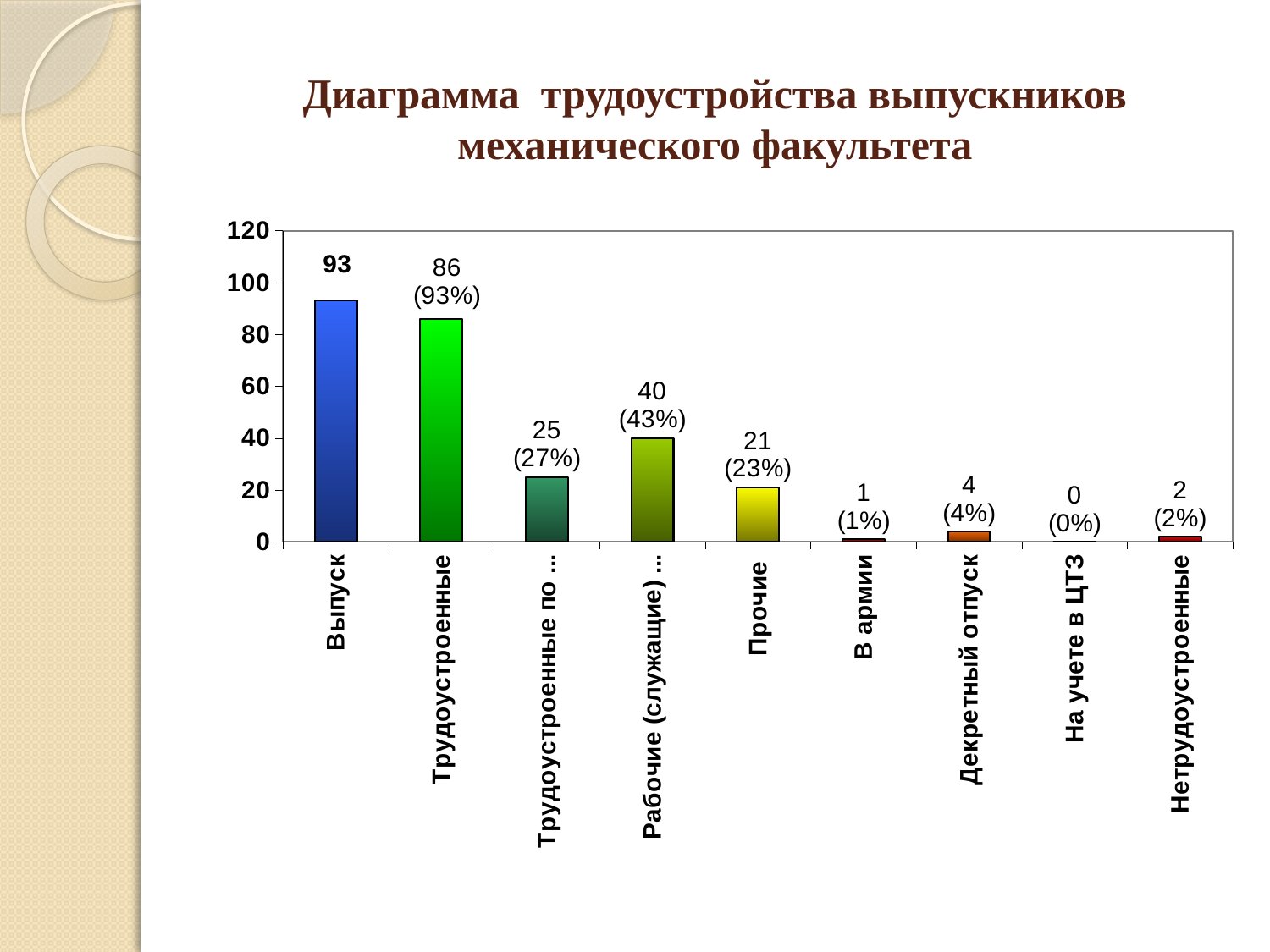
Which category has the lowest value? На учете в ЦТЗ What kind of chart is shown on the slide? Bar chart What is the value for Выпуск? 93 What is the difference between the values for Выпуск and Трудоустроенные? 7 How many categories are shown on the x axis? 9 What percentage is shown for Прочие? 23% Which is larger, the value for Декретный отпуск or the value for Нетрудоустроенные? Декретный отпуск Which category has the highest value? Выпуск What is the value for Декретный отпуск? 4 What is the title of the slide? Диаграмма трудоустройства выпускников механического факультета What is the value for На учете в ЦТЗ? 0 What is the value for Трудоустроенные? 86